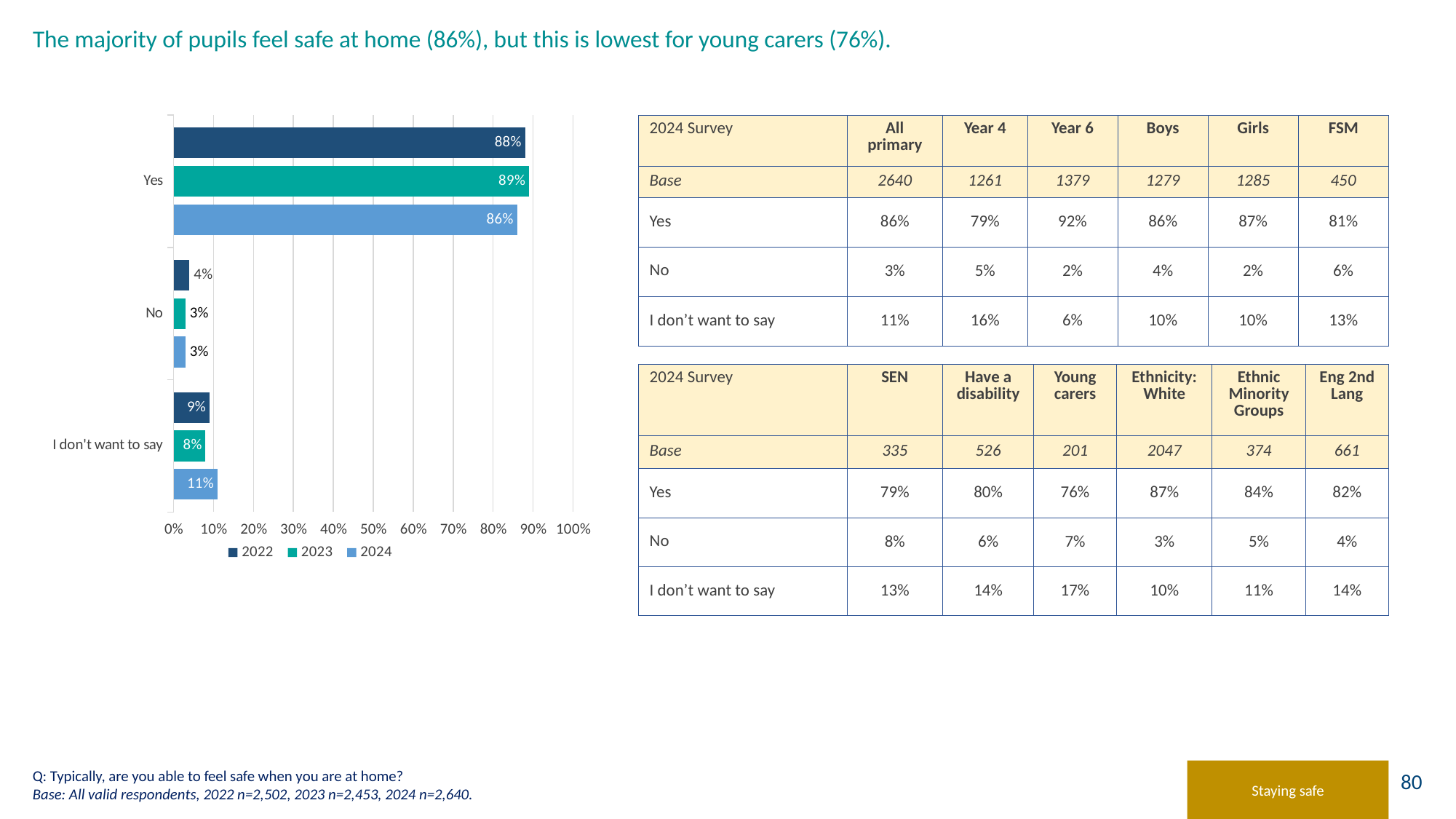
Is the 2024 value for 'Yes' greater or less than 80%? greater Which years are listed in the chart legend? 2022, 2023, 2024 How many response categories are shown on the chart? 3 What is the value for 'Yes' in the 2024 series? 86% How many series does the legend list? 3 Which year has the lowest value for 'I don't want to say'? 2023 What is the value for 'No' in the 2022 series? 4% Is the 2022 value for 'Yes' larger or smaller than the 2024 value for 'Yes'? larger What kind of chart is shown on the slide? bar chart Which year has the highest value for 'Yes'? 2023 What is the difference between the 2022 and 2024 values for 'I don't want to say'? 2% What is the value for 'I don't want to say' in the 2023 series? 8%